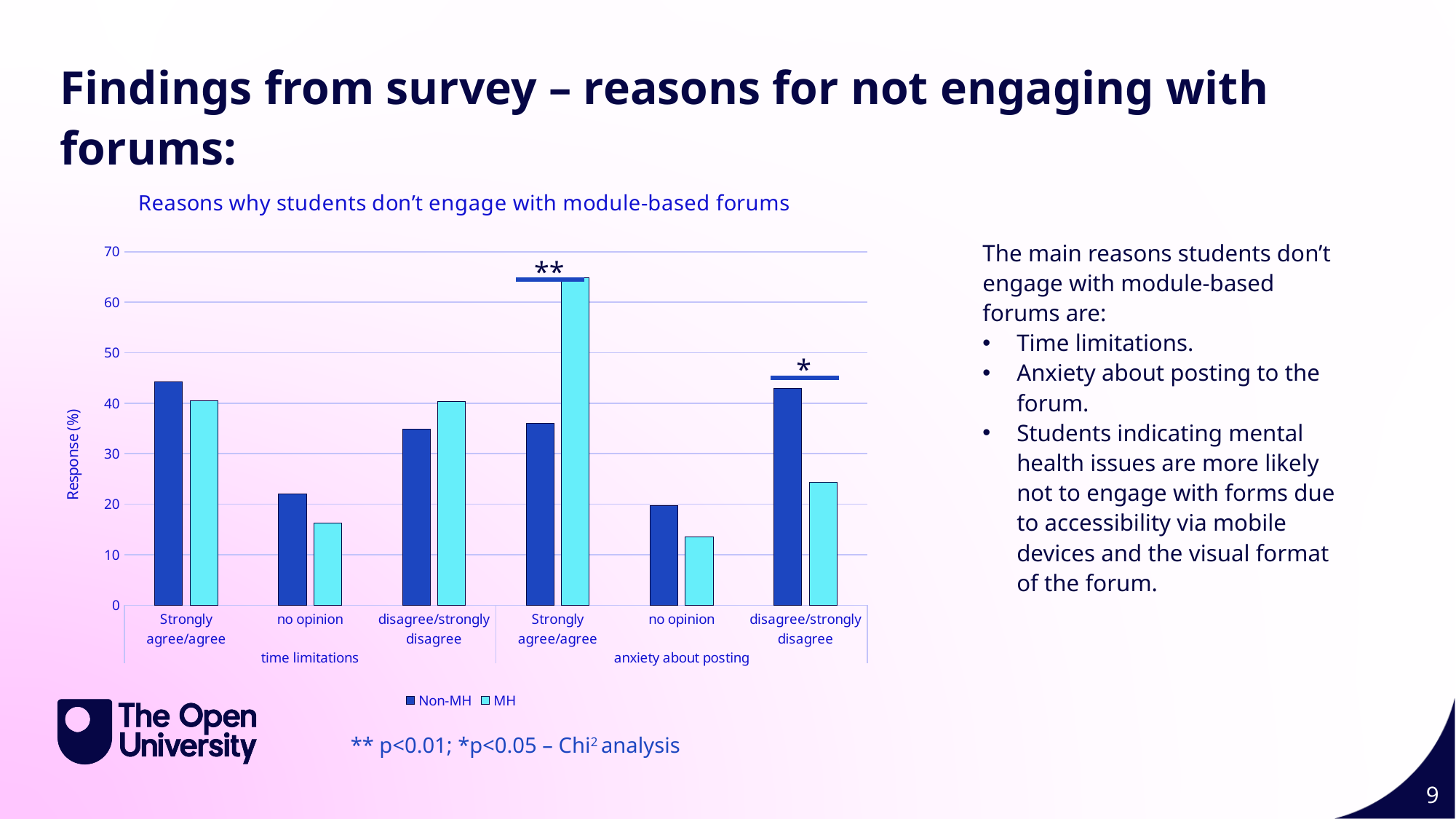
For disagree/strongly disagree under anxiety about posting, which series has the larger value, Non-MH or MH? Non-MH Is the MH value for disagree/strongly disagree under anxiety about posting greater or less than 30? less For no opinion under time limitations, which series has the larger value, Non-MH or MH? Non-MH What is the title of the chart? Reasons why students don't engage with module-based forums For Strongly agree/agree under anxiety about posting, which series has the larger value, Non-MH or MH? MH Which bar in the chart is the highest? MH, Strongly agree/agree (anxiety about posting) Is the MH value for Strongly agree/agree under anxiety about posting greater or less than 60? greater How many response categories are shown along the x axis of the chart? 6 What are the two series named in the chart legend? Non-MH and MH How many series does the chart legend list? 2 Is the Non-MH value for Strongly agree/agree under time limitations greater or less than 40? greater What kind of chart is shown on the slide? Bar chart